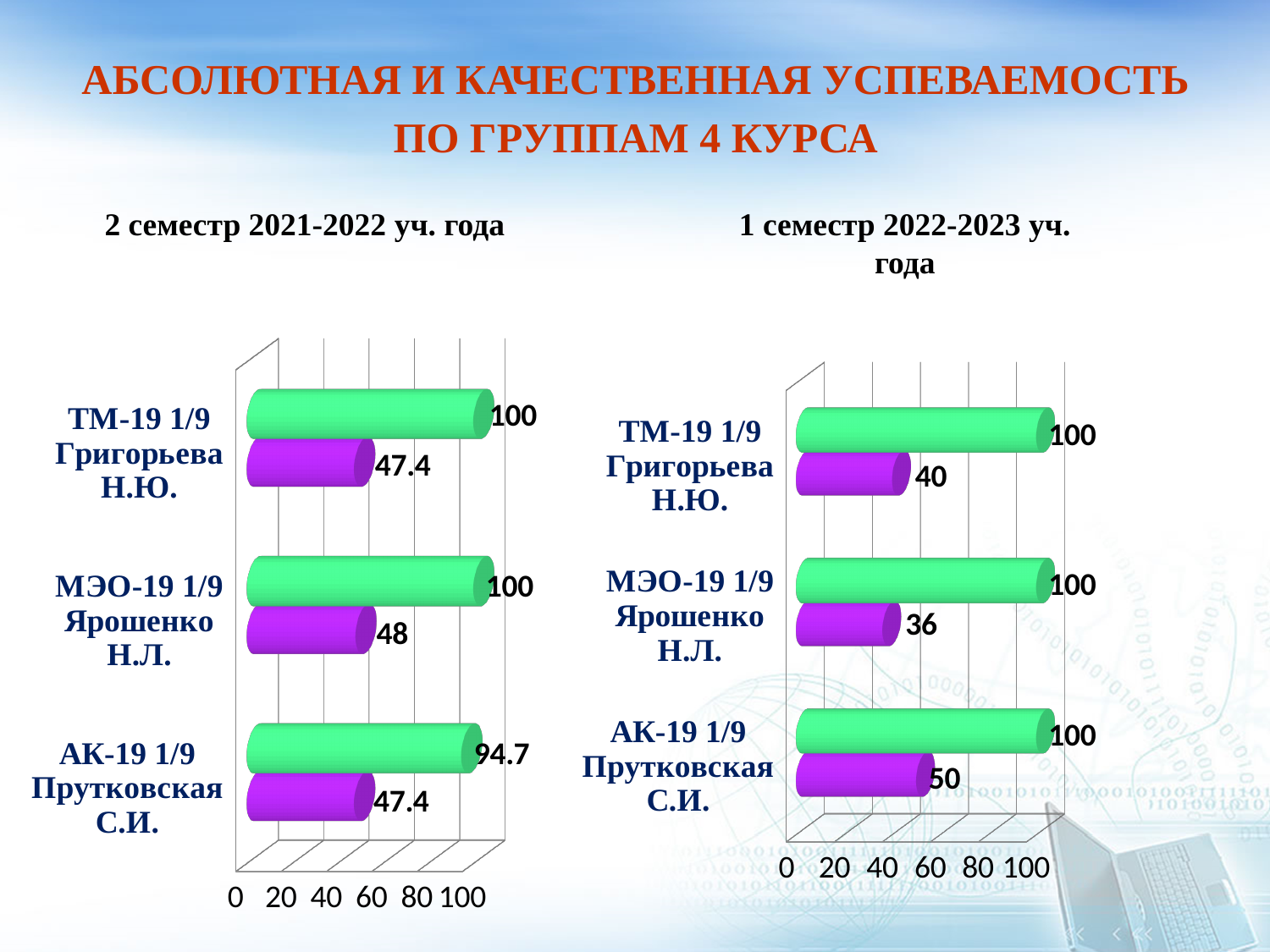
What type of chart is used on the right side of the slide (1 семестр 2022-2023 уч. года)? Bar chart On the left chart (2 семестр 2021-2022 уч. года), what is the value of the green bar for АК-19 1/9 Прутковская С.И.? 94.7 On the left chart (2 семестр 2021-2022 уч. года), what is the difference between the green and purple bar values for МЭО-19 1/9 Ярошенко Н.Л.? 52 On the right chart (1 семестр 2022-2023 уч. года), which group has the highest purple bar value? АК-19 1/9 Прутковская С.И. On the right chart (1 семестр 2022-2023 уч. года), what is the value of the purple bar for МЭО-19 1/9 Ярошенко Н.Л.? 36 How many groups are shown on the left chart (2 семестр 2021-2022 уч. года)? 3 On the right chart (1 семестр 2022-2023 уч. года), which group has the lowest purple bar value? МЭО-19 1/9 Ярошенко Н.Л. Is the purple bar value for ТМ-19 1/9 Григорьева Н.Ю. larger on the left chart (2 семестр 2021-2022) or on the right chart (1 семестр 2022-2023)? Left chart (2 семестр 2021-2022) On the right chart (1 семестр 2022-2023 уч. года), what is the difference between the purple bar values for АК-19 1/9 Прутковская С.И. and МЭО-19 1/9 Ярошенко Н.Л.? 14 On the right chart (1 семестр 2022-2023 уч. года), what is the value of the purple bar for АК-19 1/9 Прутковская С.И.? 50 On the left chart (2 семестр 2021-2022 уч. года), what is the value of the purple bar for ТМ-19 1/9 Григорьева Н.Ю.? 47.4 On the left chart (2 семестр 2021-2022 уч. года), which group has the lowest green bar value? АК-19 1/9 Прутковская С.И.